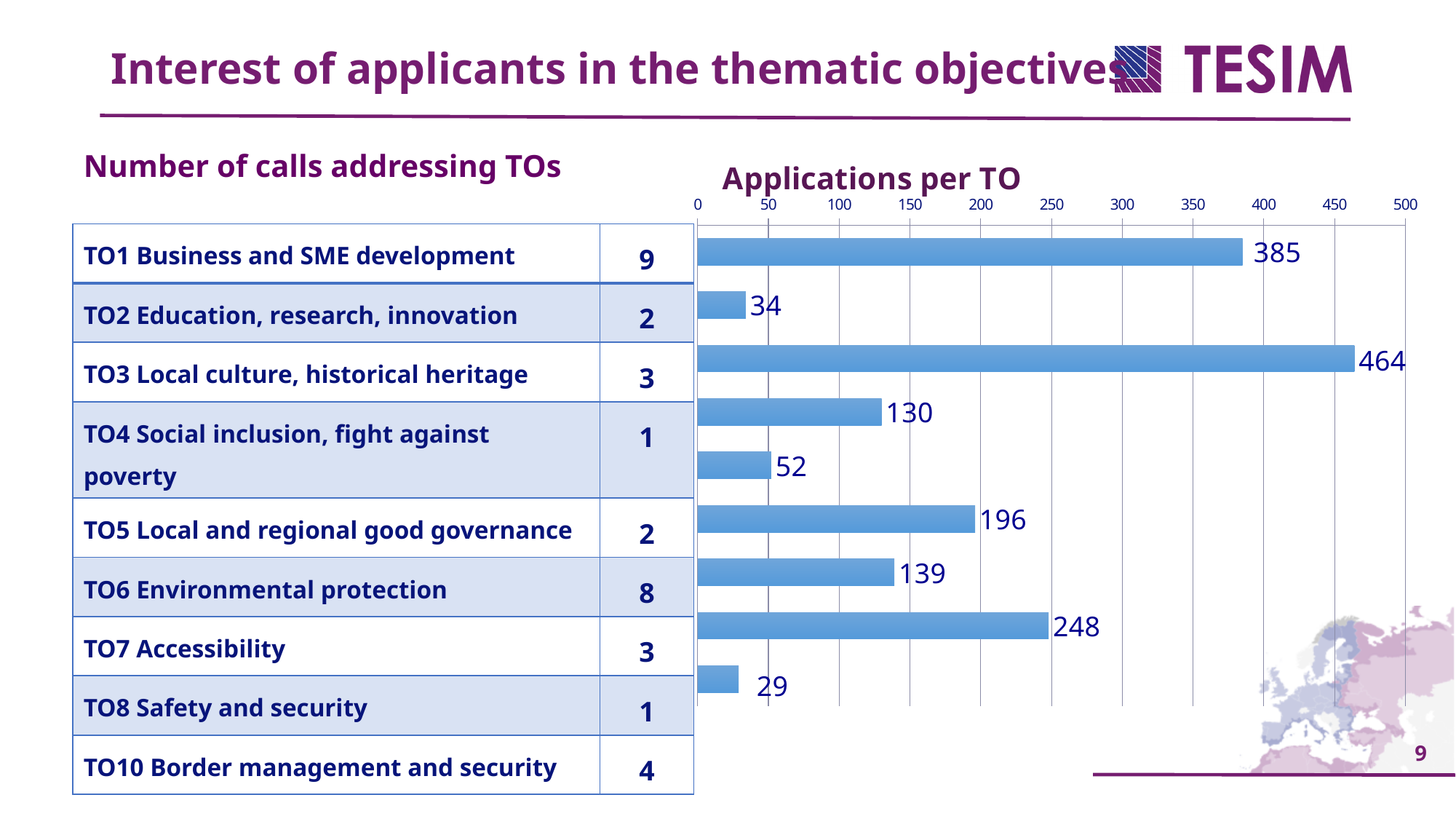
In the 'Applications per TO' chart, what is the value of the top bar? 385 In the 'Applications per TO' chart, what is the value of the second bar from the bottom? 248 In the 'Applications per TO' chart, how many bars are plotted? 9 In the 'Applications per TO' chart, which is larger: the sixth bar from the top (196) or the seventh bar from the top (139)? 196 In the 'Applications per TO' chart, what is the lowest value shown? 29 In the 'Applications per TO' chart, what is the value of the bottom bar? 29 In the 'Applications per TO' chart, what is the highest value shown? 464 In the 'Applications per TO' chart, what is the value of the third bar from the top? 464 In the 'Applications per TO' chart, what is the difference between the largest bar (464) and the top bar (385)? 79 What is the title of the chart on the right side of the slide? Applications per TO What type of chart is 'Applications per TO'? bar chart In the 'Applications per TO' chart, what is the maximum value shown on the horizontal axis? 500